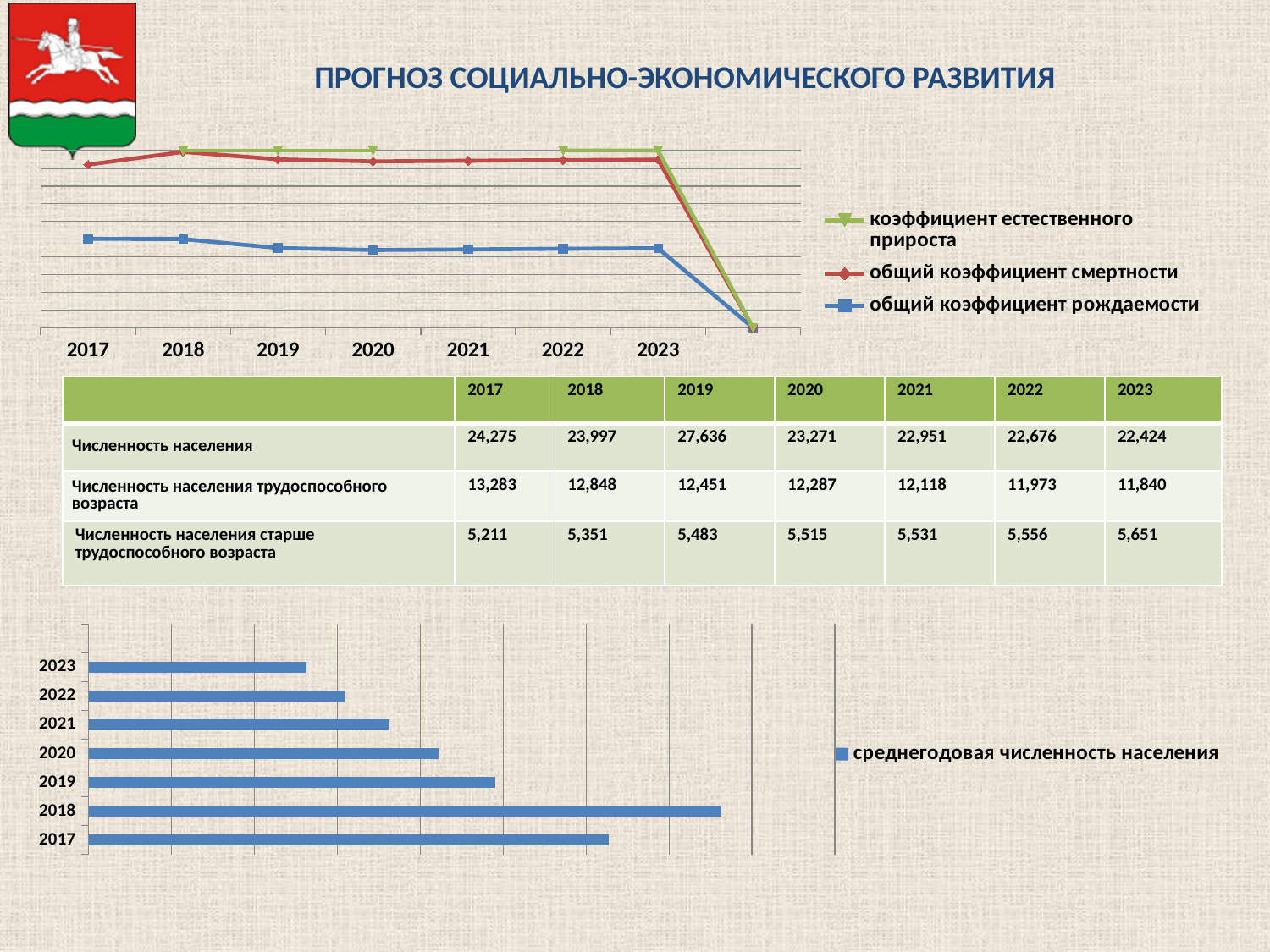
In the bottom bar chart, which year has the longest bar? 2018 In the top line chart, which series is shown with a blue line and square markers? общий коэффициент рождаемости How many bars are shown in the bottom bar chart? 7 How many years are labelled on the x axis of the top line chart? 7 How many series does the legend of the top line chart list? 3 What kind of chart is the bottom chart on the slide? bar chart What kind of chart is the top chart on the slide? line chart In the bottom bar chart, which bar is longer: 2017 or 2019? 2017 In the bottom bar chart, do the bars get longer or shorter from 2018 to 2023? shorter In the bottom bar chart, which year has the shortest bar? 2023